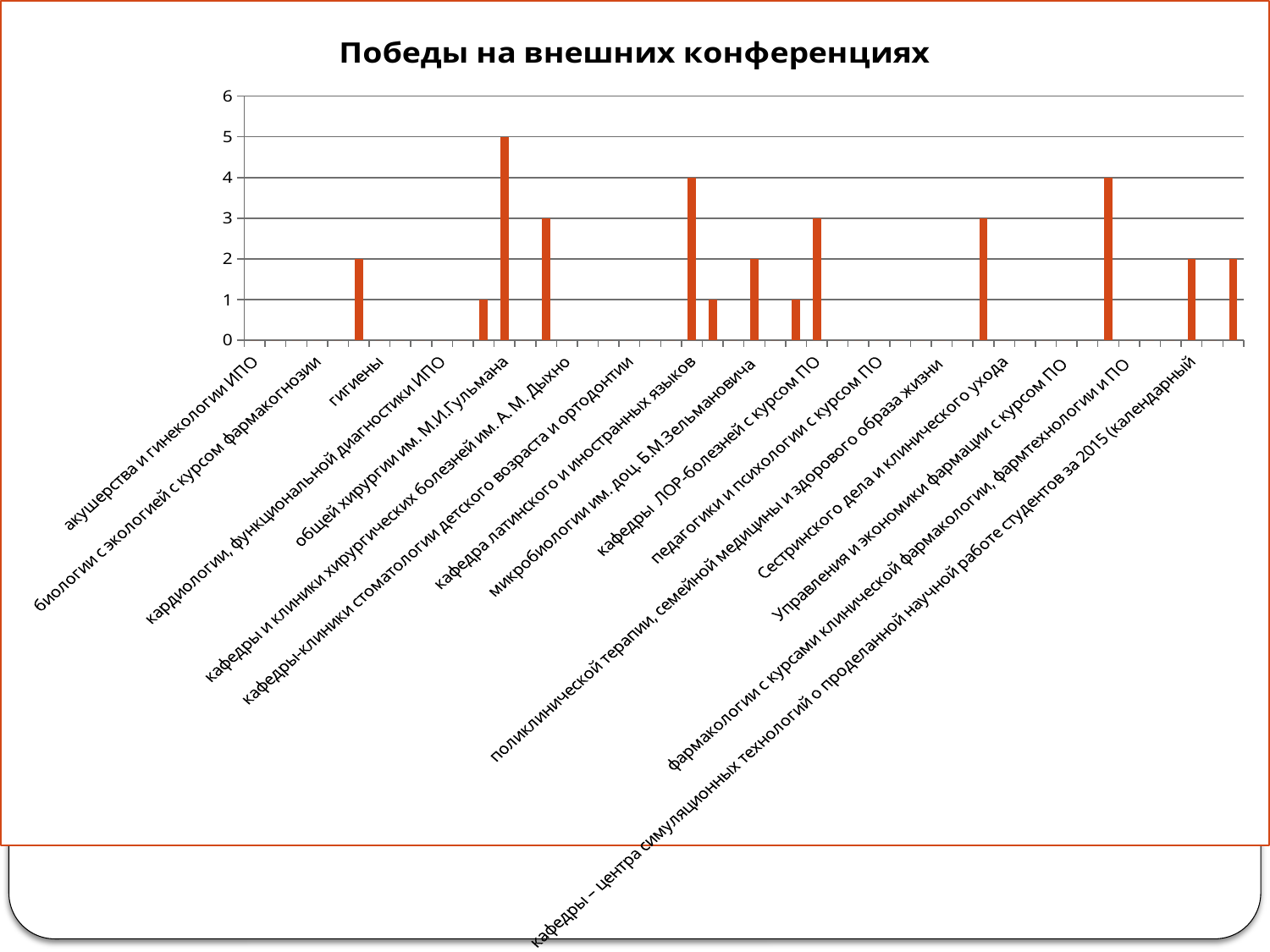
What is the title of the chart? Победы на внешних конференциях What is the value for кафедры ЛОР-болезней с курсом ПО? 3 Which department has the highest number of wins at external conferences? общей хирургии им. М.И.Гульмана How many bars with a non-zero value are shown in the chart? 13 Which is larger: the value for общей хирургии им. М.И.Гульмана or the value for кафедра латинского и иностранных языков? общей хирургии им. М.И.Гульмана What is the value for кафедра латинского и иностранных языков? 4 Is the value for общей хирургии им. М.И.Гульмана greater or less than 4? greater What is the highest value reached by any bar in the chart? 5 What is the difference between the value for общей хирургии им. М.И.Гульмана and the value for кафедры ЛОР-болезней с курсом ПО? 2 What is the maximum value shown on the vertical axis? 6 What type of chart is shown on the slide? bar chart What is the value for общей хирургии им. М.И.Гульмана? 5